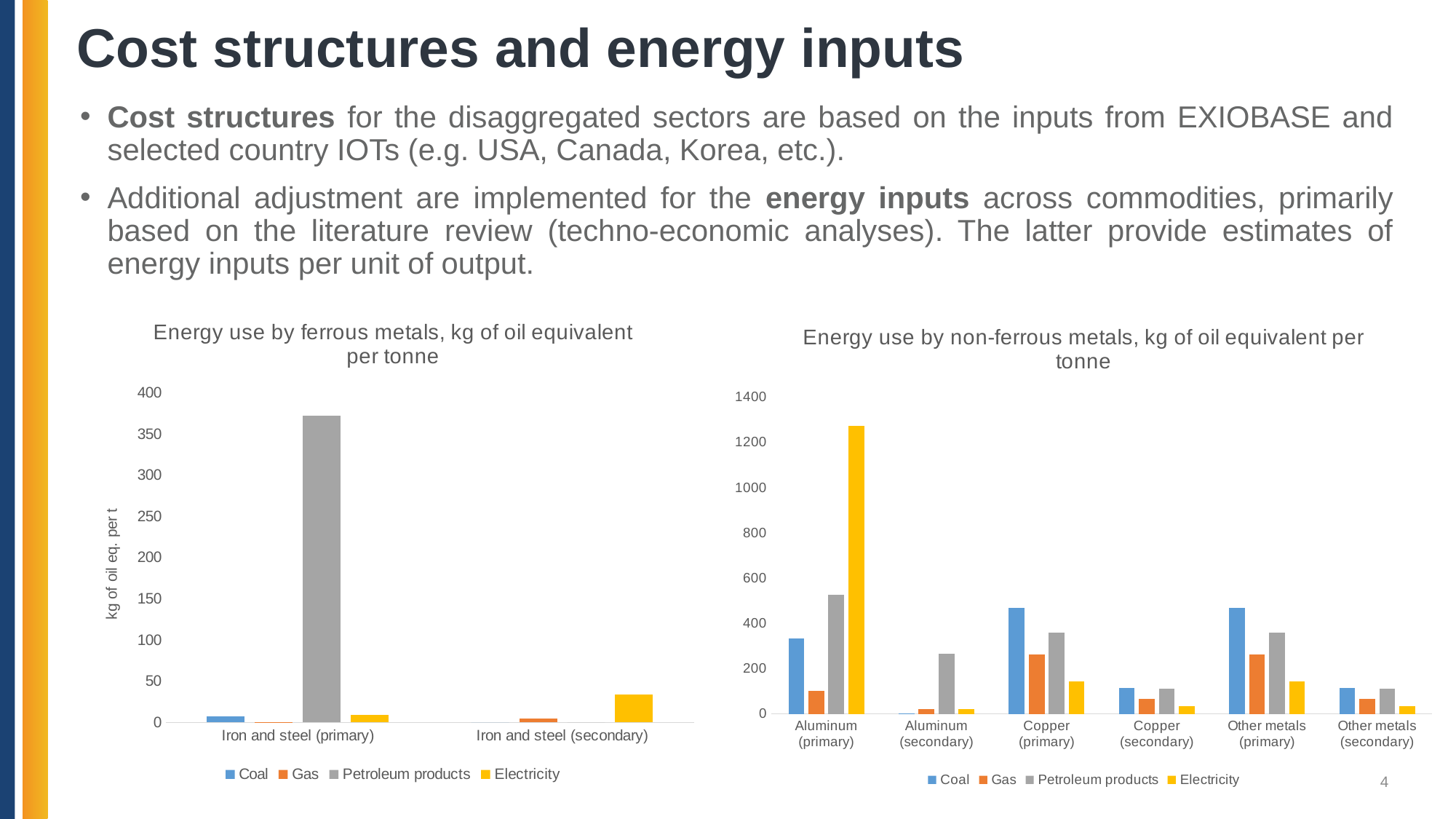
In the right chart (non-ferrous metals), how many categories are shown on the x axis? 6 In the left chart (ferrous metals), is the value of Electricity for Iron and steel (secondary) greater or less than 50? less In the right chart (non-ferrous metals), is the Coal value for Copper (primary) greater or less than 400? greater In the right chart (non-ferrous metals), which category has the highest Electricity value? Aluminum (primary) In the left chart (ferrous metals), how many categories are shown on the x axis? 2 In the right chart (non-ferrous metals), which is larger for Copper (primary): Coal or Gas? Coal In the left chart (ferrous metals), is the value of Petroleum products for Iron and steel (primary) greater or less than 350? greater In the right chart (non-ferrous metals), how many series does the legend list? 4 What type of chart is the left chart titled 'Energy use by ferrous metals, kg of oil equivalent per tonne'? bar chart What is the y-axis label of the left chart (ferrous metals)? kg of oil eq. per t In the left chart (ferrous metals), which series has the highest value for Iron and steel (primary)? Petroleum products